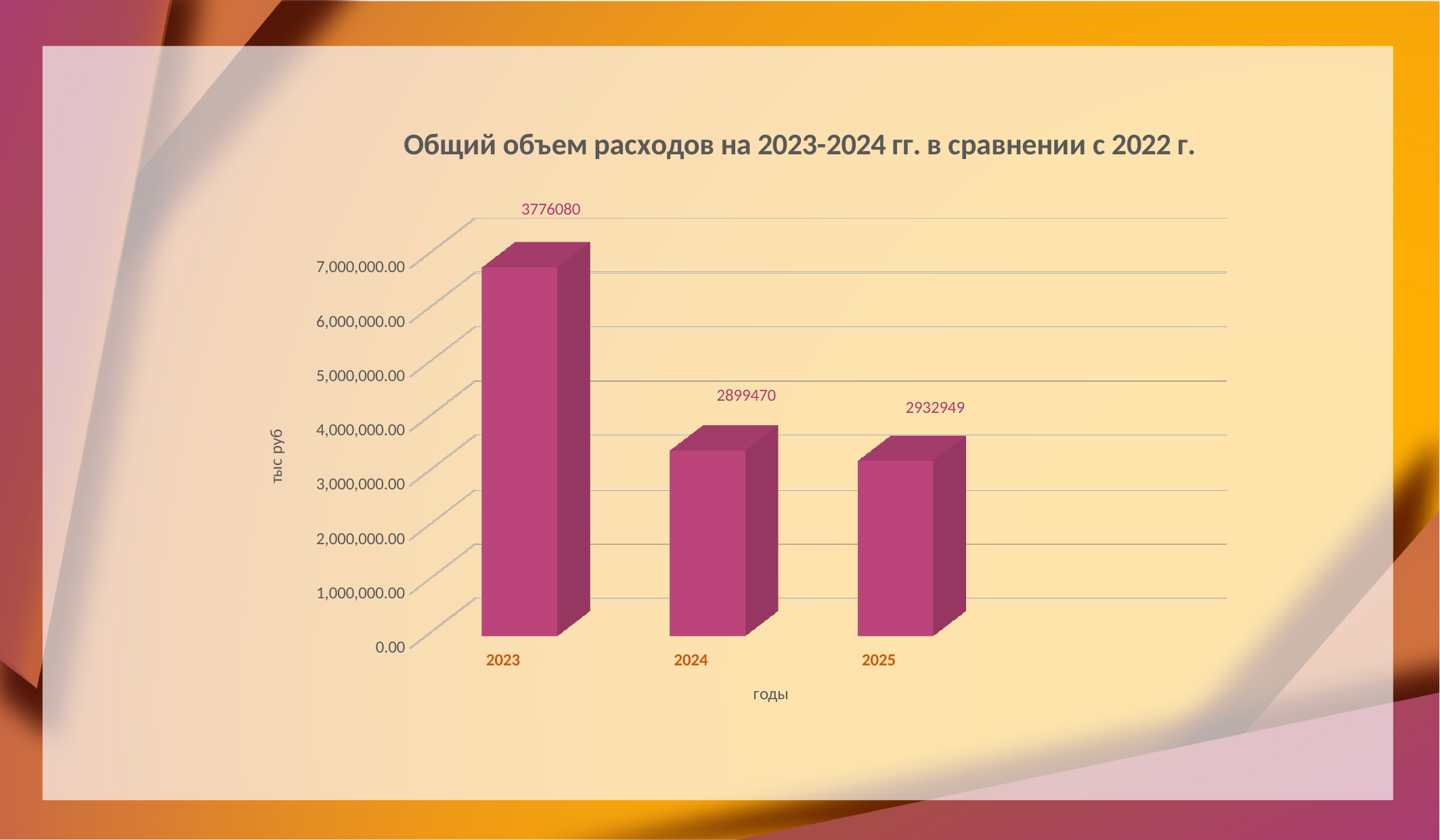
What is the label of the vertical axis? тыс руб What is the value shown for 2025? 2932949 Does the value rise or fall from 2023 to 2024? fall What is the title of the chart? Общий объем расходов на 2023-2024 гг. в сравнении с 2022 г. What is the difference between the values for 2023 and 2024? 876610 Which is larger, the value for 2023 or the value for 2024? 2023 What kind of chart is shown on the slide? bar chart What is the difference between the values for 2023 and 2025? 843131 What is the value shown for 2024? 2899470 How many years are shown on the x axis? 3 Which year has the highest value? 2023 What is the value shown for 2023? 3776080